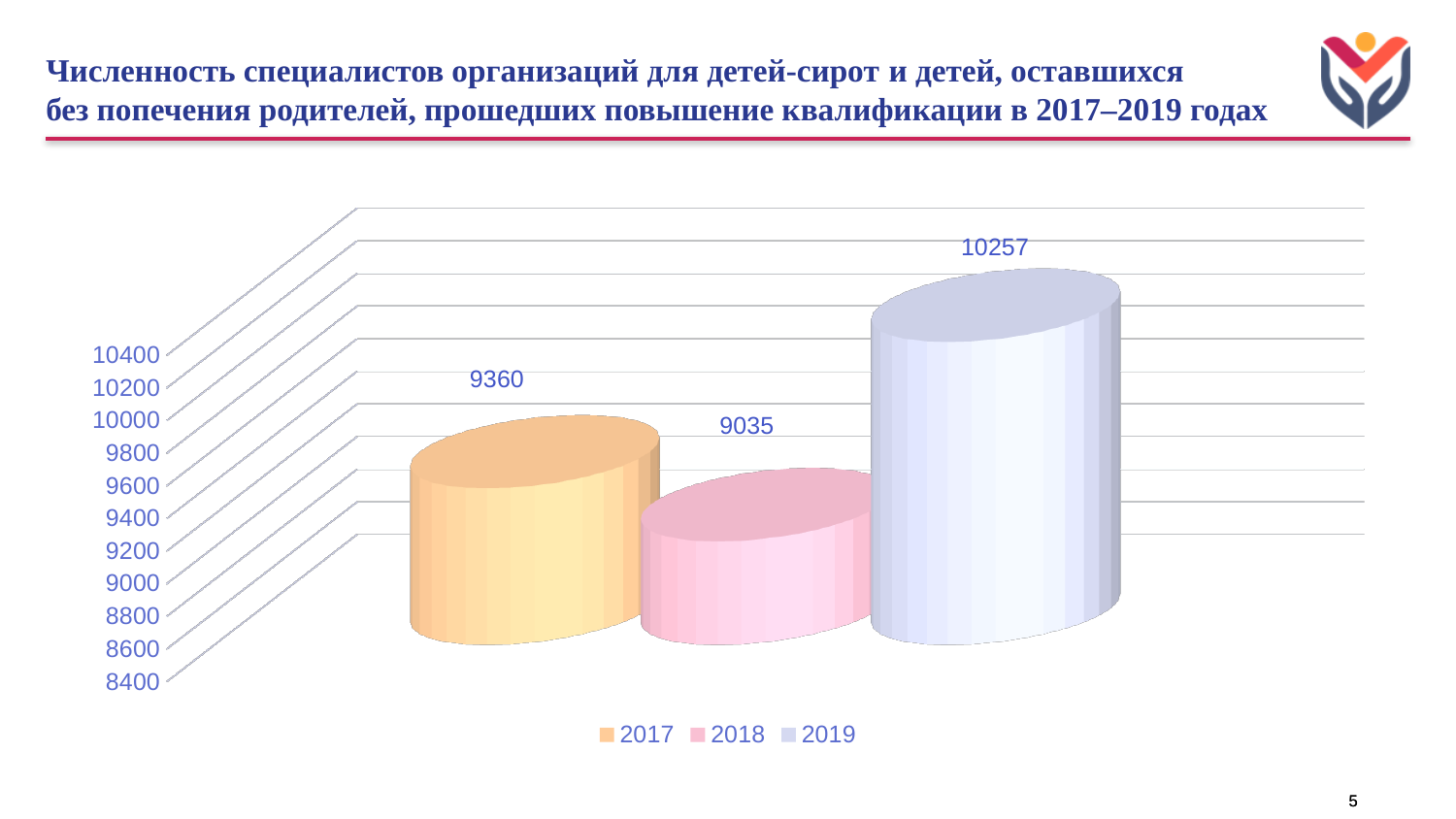
What is the value for 2017? 9360 What is the difference between the values for 2019 and 2018? 1222 How many entries does the legend list? 3 Which year has the highest value? 2019 What is the difference between the values for 2017 and 2018? 325 What kind of chart is shown on the slide? bar chart Which year has the lowest value? 2018 Is the value for 2019 greater or less than 10000? greater How many bars are plotted on the chart? 3 What is the value for 2018? 9035 What is the value for 2019? 10257 Which is larger, the value for 2017 or the value for 2018? 2017